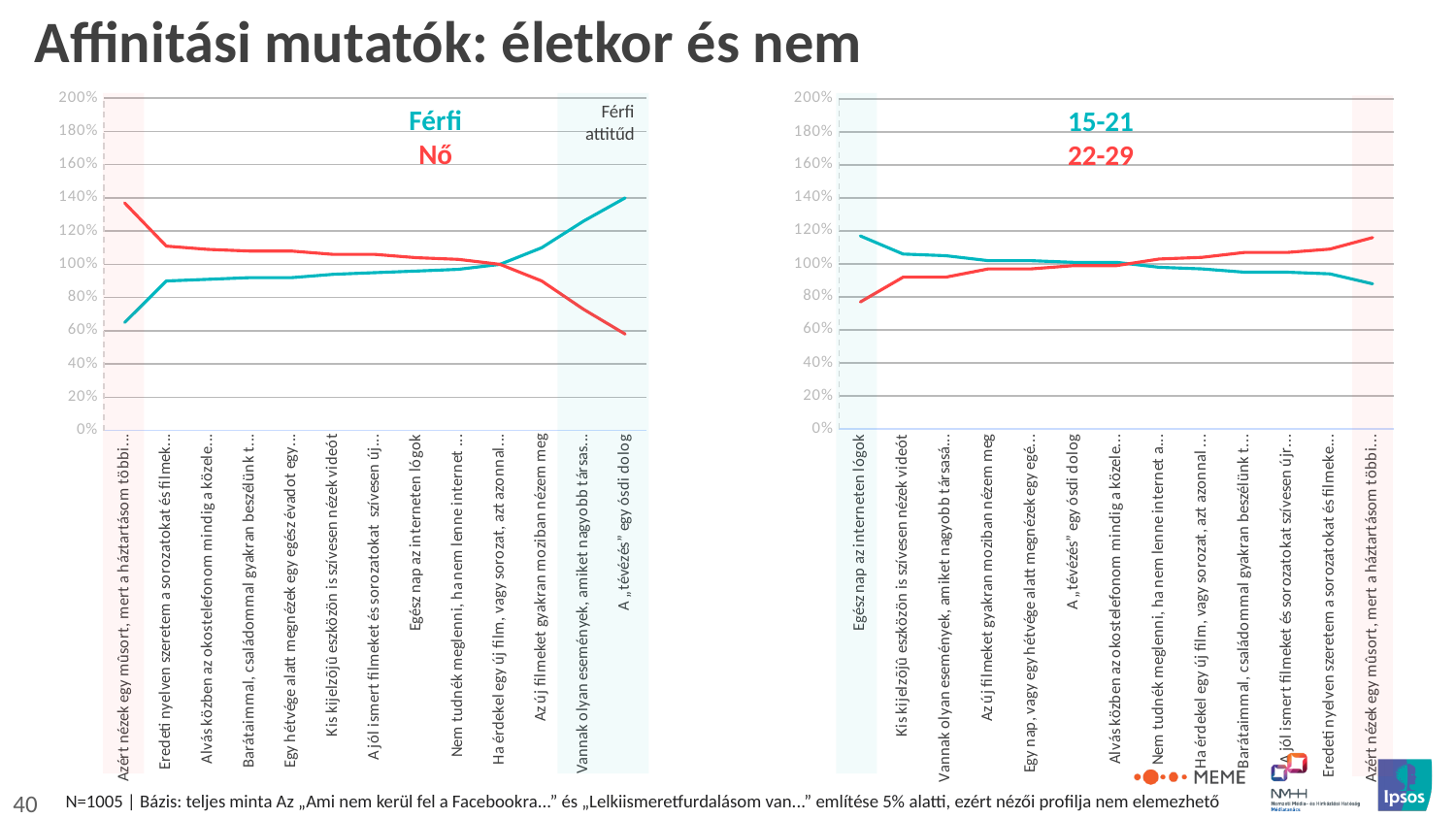
In the left chart, is the Férfi value for "Azért nézek egy műsort, mert a háztartásom többi..." greater or less than 80%? less In the left chart, is the Férfi value for "A „tévézés” egy ósdi dolog" greater or less than 120%? greater What kind of chart is the left chart (Férfi / Nő)? line chart In the left chart, does the Férfi line generally rise or fall from left to right along the x axis? rise In the left chart, which series has the higher value for "A „tévézés” egy ósdi dolog", Férfi or Nő? Férfi How many categories are plotted along the x axis of the left chart? 13 In the right chart, does the 22-29 line generally rise or fall from left to right along the x axis? rise How many series does the legend of the right chart list? 2 In the right chart, is the 15-21 value for "Egész nap az interneten lógok" greater or less than 100%? greater In the right chart, which series has the higher value for "Azért nézek egy műsort, mert a háztartásom többi...", 15-21 or 22-29? 22-29